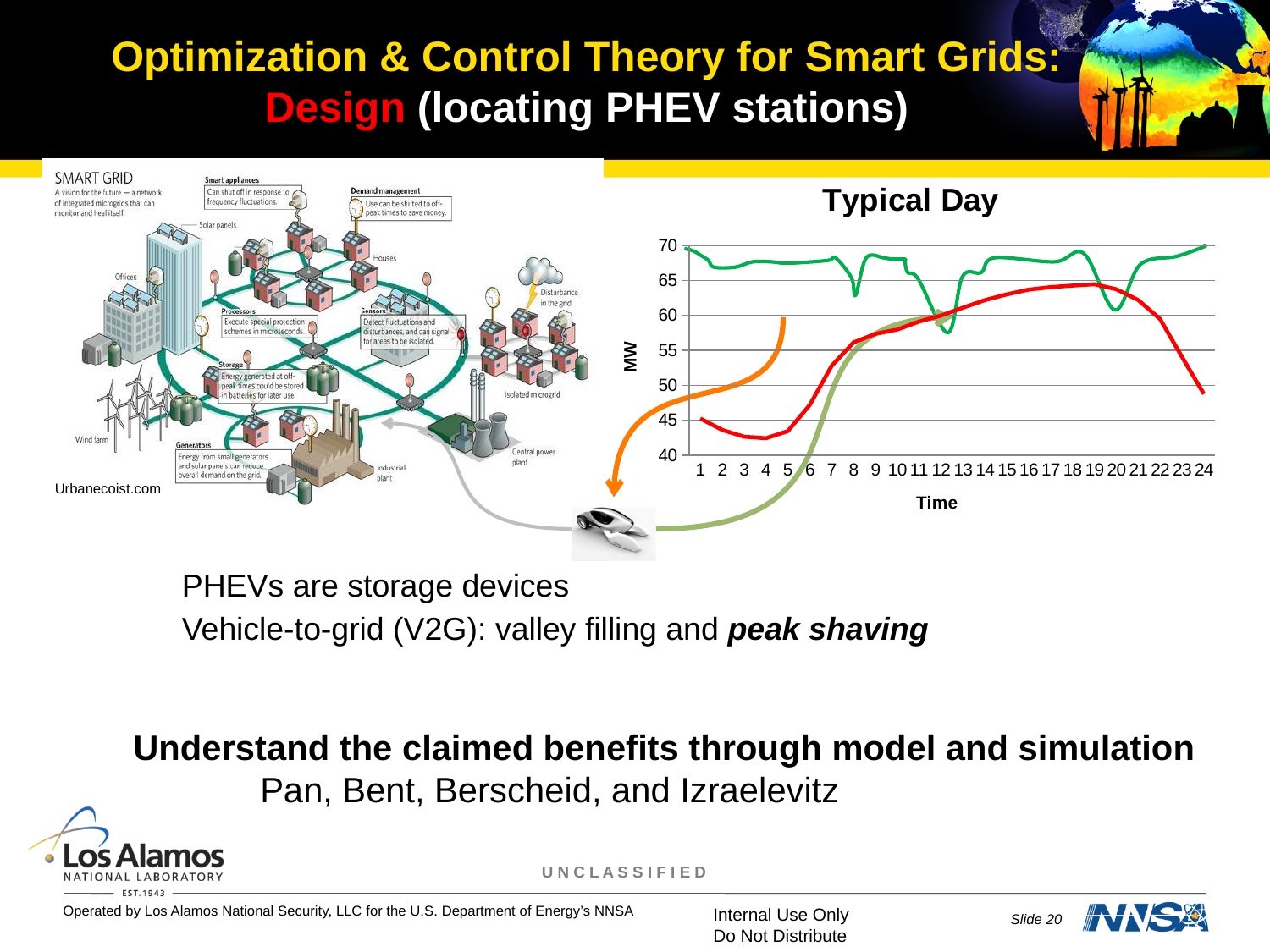
In the "Typical Day" chart, does the red line rise or fall between time 19 and time 24? fall In the "Typical Day" chart, is the value of the red line at time 19 greater or less than 60? greater What kind of chart is the "Typical Day" chart? line chart In the "Typical Day" chart, is the value of the green line at time 12 greater or less than 65? less In the "Typical Day" chart, which line has the higher value at time 1, the green line or the red line? green line In the "Typical Day" chart, which line has the higher value at time 24, the green line or the red line? green line What is the label of the vertical axis of the "Typical Day" chart? MW How many time points are labelled along the x axis of the "Typical Day" chart? 24 What is the title of the chart on the slide? Typical Day In the "Typical Day" chart, is the value of the red line at time 24 greater or less than 55? less